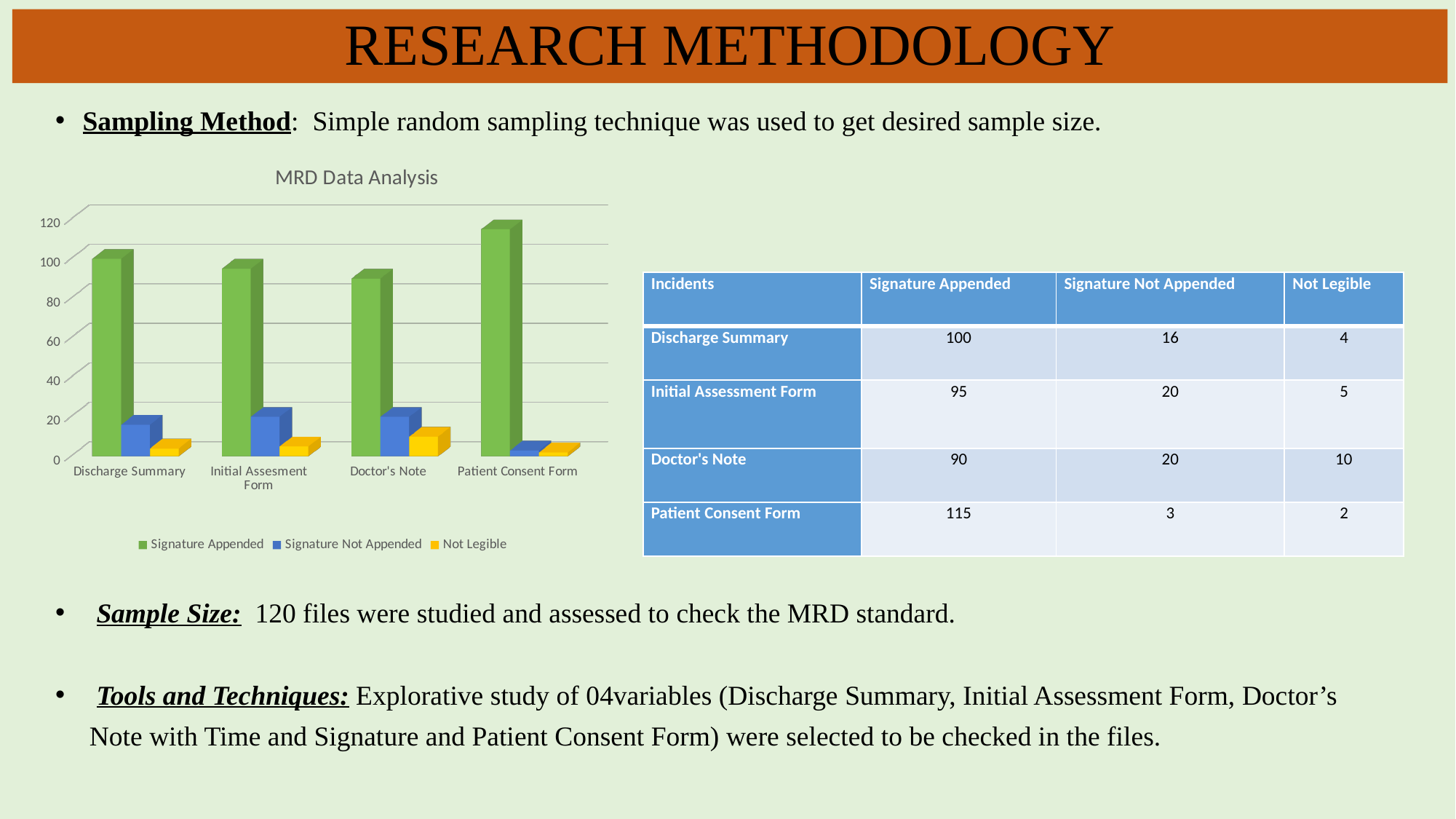
Which is larger in the MRD Data Analysis chart: the Signature Not Appended value for Doctor's Note or the Signature Not Appended value for Patient Consent Form? Doctor's Note How many categories are shown on the x axis of the MRD Data Analysis chart? 4 Is the Signature Appended value for Discharge Summary greater or less than 80? greater How many series does the legend of the MRD Data Analysis chart list? 3 What type of chart is the MRD Data Analysis chart? bar chart Which category has the lowest Signature Appended value in the MRD Data Analysis chart? Doctor's Note Which category has the highest Signature Appended value in the MRD Data Analysis chart? Patient Consent Form What is the difference between the Signature Appended values for Patient Consent Form and Discharge Summary? 15 What is the Not Legible value for Doctor's Note? 10 What colour represents the Not Legible series in the MRD Data Analysis chart? yellow What is the Signature Appended value for Patient Consent Form? 115 Is the Signature Not Appended value for Patient Consent Form greater or less than 20? less